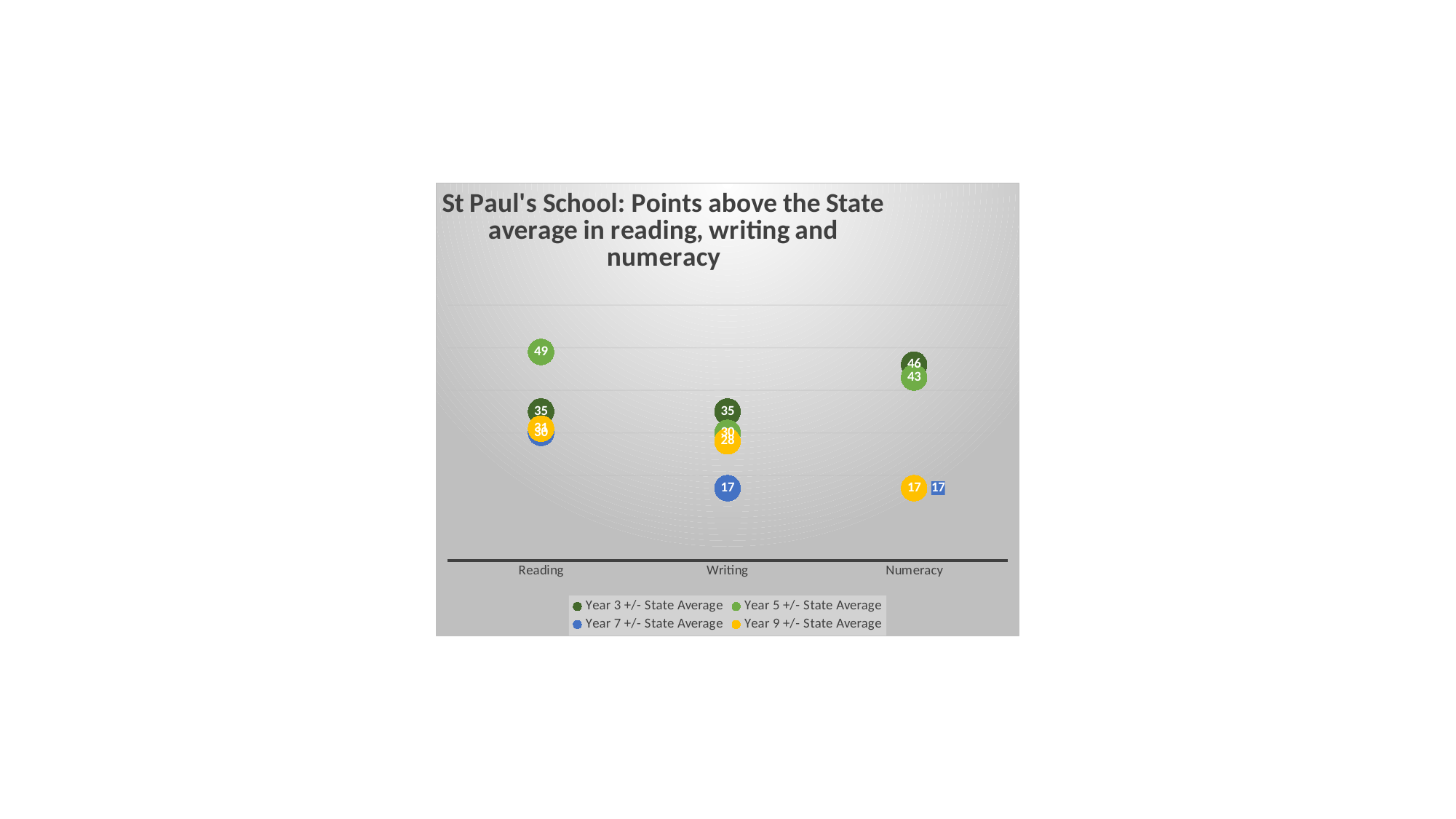
What is the value for Year 5 +/- State Average in Reading? 49 How many subject categories are shown on the x axis? 3 In Reading, which is larger: the Year 3 value or the Year 5 value? Year 5 In which subject is the Year 3 +/- State Average value highest? Numeracy How many series does the legend list? 4 What is the value for Year 7 +/- State Average in Writing? 17 What is the value for Year 3 +/- State Average in Writing? 35 What is the value for Year 9 +/- State Average in Numeracy? 17 What is the difference between the Year 5 value in Reading and the Year 5 value in Numeracy? 6 What is the value for Year 5 +/- State Average in Numeracy? 43 What is the difference between the Year 3 and Year 5 values in Numeracy? 3 What is the value for Year 3 +/- State Average in Numeracy? 46